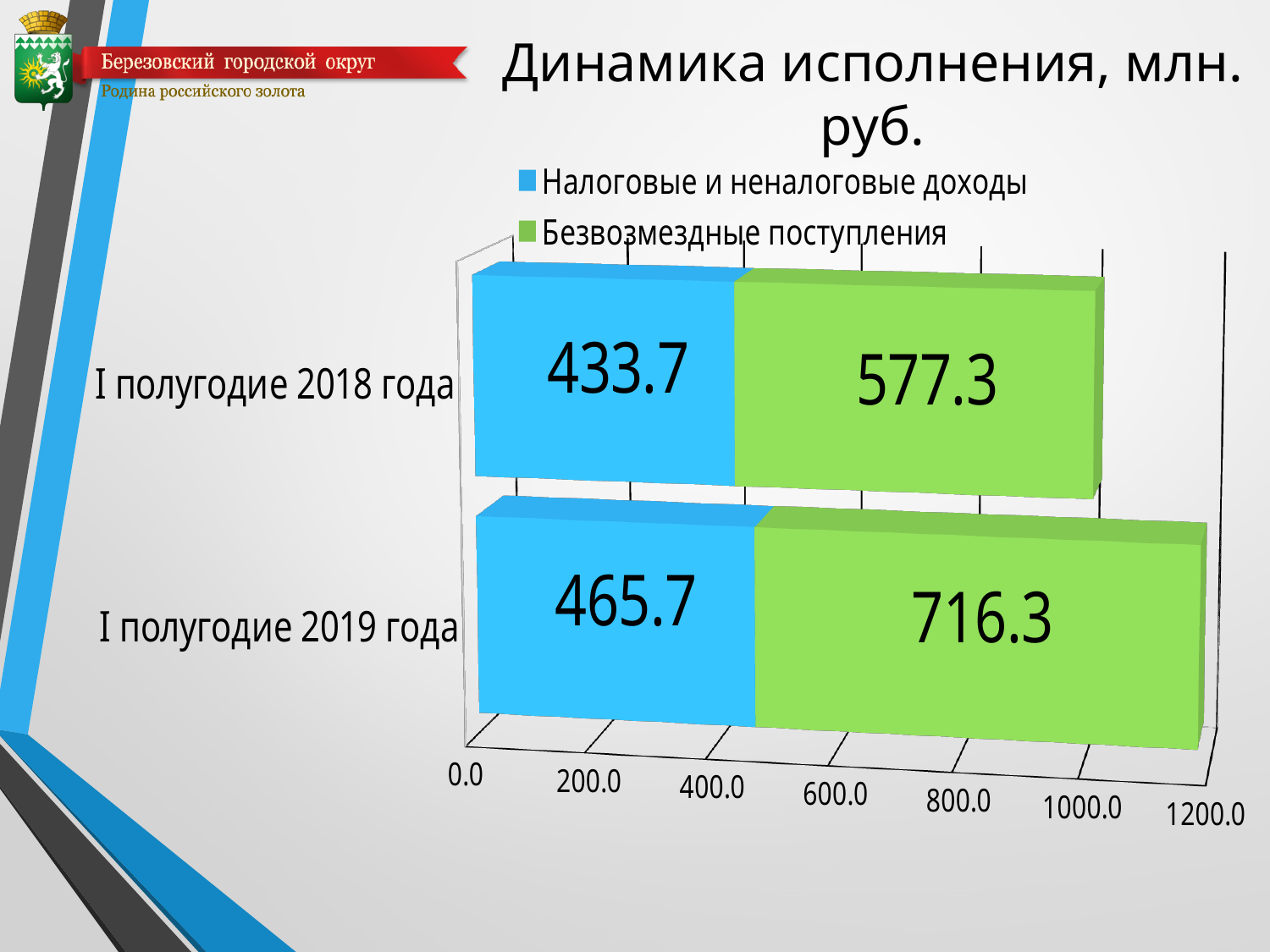
What is the value of Безвозмездные поступления for I полугодие 2019 года? 716.3 Is Безвозмездные поступления larger in I полугодие 2018 года or in I полугодие 2019 года? I полугодие 2019 года Which period has the lower value for Налоговые и неналоговые доходы? I полугодие 2018 года What is the value of Налоговые и неналоговые доходы for I полугодие 2019 года? 465.7 Which period has the higher value for Безвозмездные поступления? I полугодие 2019 года How many series does the legend list? 2 What is the total of the stacked bar for I полугодие 2019 года? 1182.0 What is the total of the stacked bar for I полугодие 2018 года? 1011.0 What kind of chart is shown on the slide? Stacked bar chart What is the difference between Безвозмездные поступления in I полугодие 2019 года and I полугодие 2018 года? 139.0 What is the value of Налоговые и неналоговые доходы for I полугодие 2018 года? 433.7 What is the value of Безвозмездные поступления for I полугодие 2018 года? 577.3